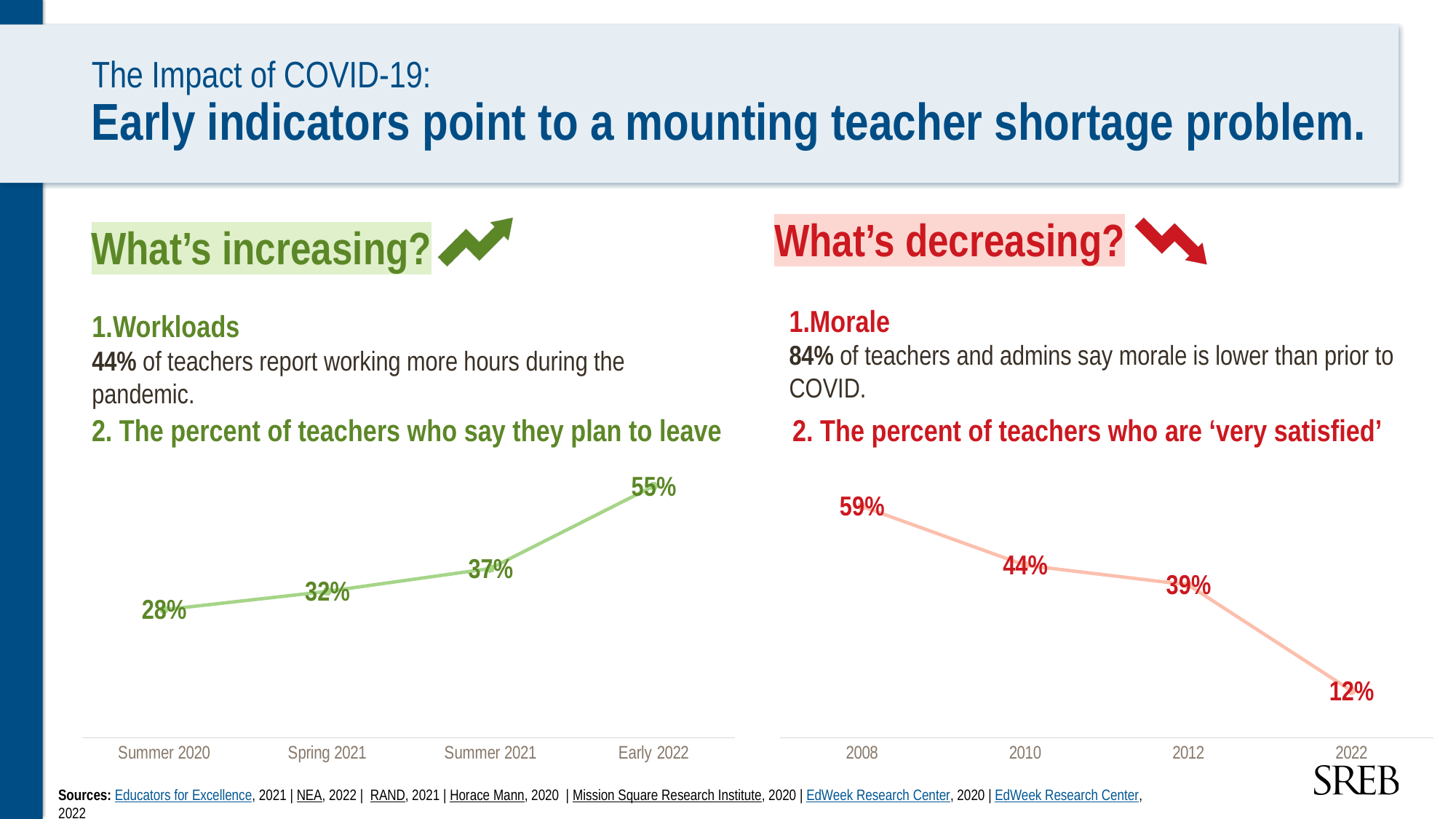
In the right chart (percent of teachers who are 'very satisfied'), what is the value for 2022? 12% In the left chart (percent of teachers who say they plan to leave), what is the difference between the Early 2022 and Summer 2020 values? 27 percentage points In the right chart (percent of teachers who are 'very satisfied'), what is the difference between the 2008 and 2022 values? 47 percentage points In the right chart (percent of teachers who are 'very satisfied'), do the values rise or fall from 2008 to 2022? Fall In the right chart (percent of teachers who are 'very satisfied'), which year has the lowest value? 2022 In the left chart (percent of teachers who say they plan to leave), what is the value for Early 2022? 55% In the right chart (percent of teachers who are 'very satisfied'), which is larger: the value for 2010 or the value for 2012? 2010 How many data points are plotted in the left chart (percent of teachers who say they plan to leave)? 4 What kind of chart is the right chart (percent of teachers who are 'very satisfied')? Line chart In the left chart (percent of teachers who say they plan to leave), what is the value for Summer 2020? 28% In the left chart (percent of teachers who say they plan to leave), which period has the highest value? Early 2022 In the right chart (percent of teachers who are 'very satisfied'), what is the value for 2012? 39%